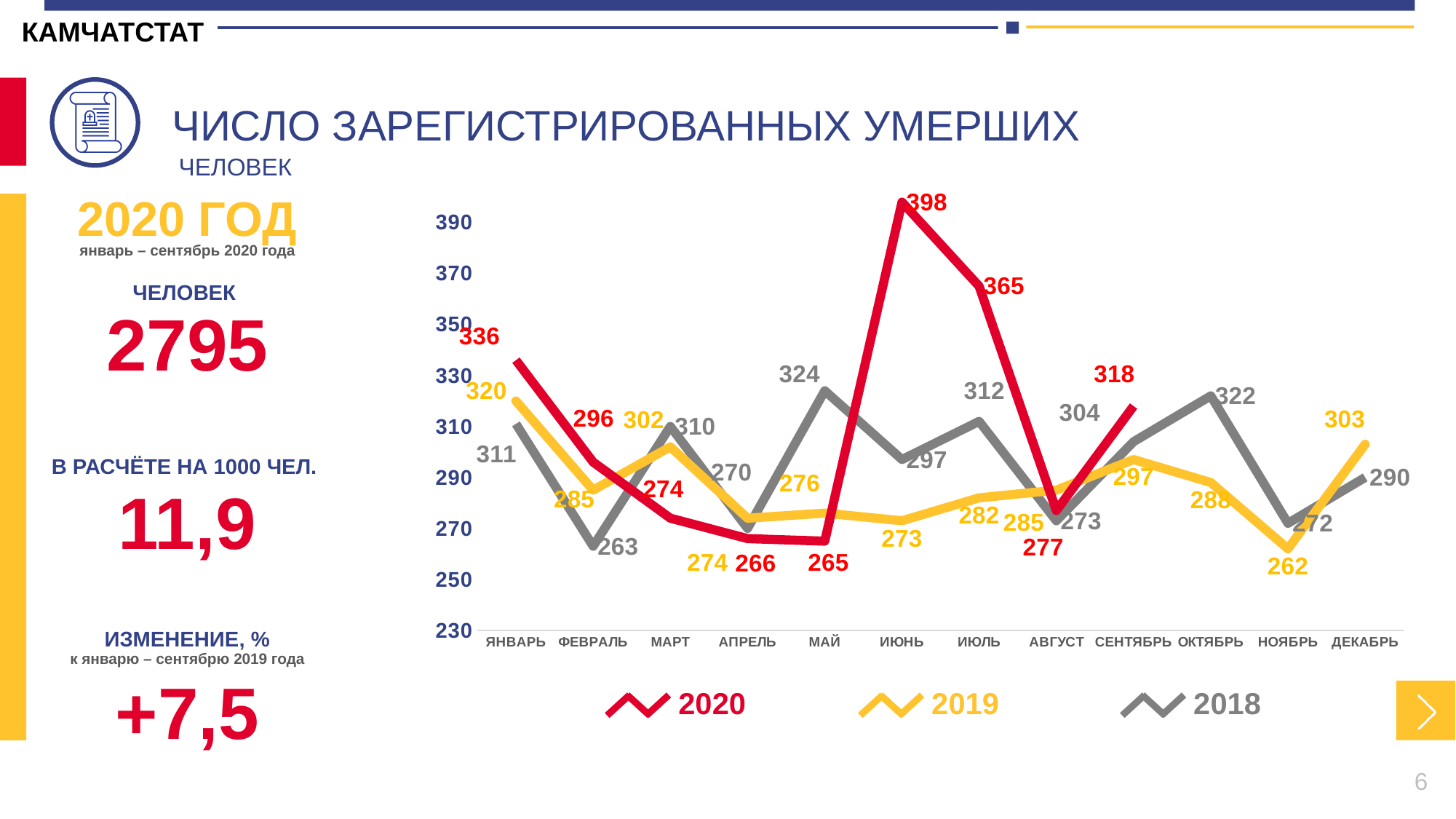
In which month does the 2019 series have its lowest value? November (НОЯБРЬ) Does the 2020 series rise or fall from January to May? Falls What is the value for 2020 in June (ИЮНЬ)? 398 How many series does the legend list? 3 How many months are shown on the x axis? 12 What kind of chart is shown on the slide? Line chart In which month does the 2020 series reach its highest value? June (ИЮНЬ) What is the difference between the 2020 values for June and May? 133 What is the difference between the 2018 and 2019 values in October (ОКТЯБРЬ)? 34 Which series has the larger value in January (ЯНВАРЬ): 2020 or 2019? 2020 What is the value for 2018 in May (МАЙ)? 324 What is the value for 2019 in November (НОЯБРЬ)? 262